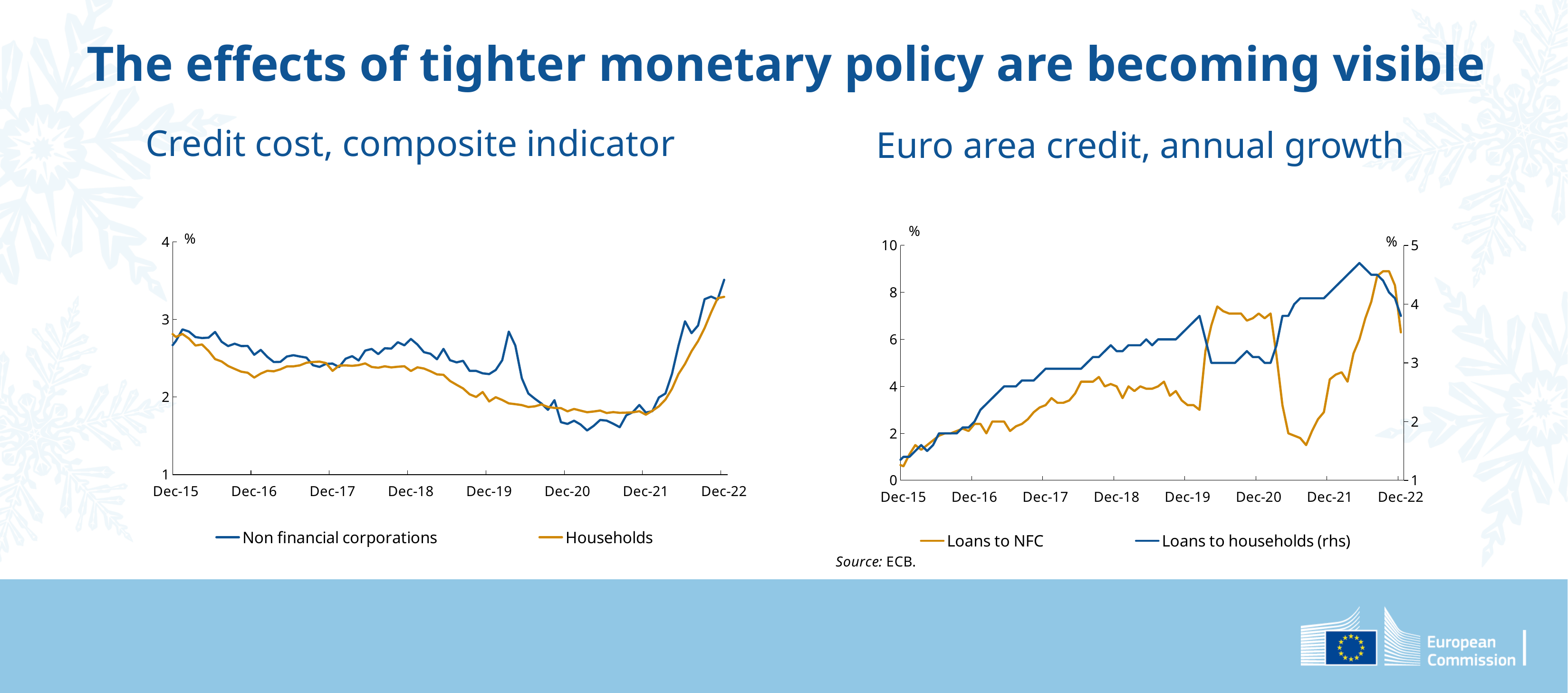
In the 'Euro area credit, annual growth' chart, is the value for Loans to NFC at Dec-15 greater or less than 2? less How many series does the legend of the 'Credit cost, composite indicator' chart list? 2 In the 'Euro area credit, annual growth' chart, is the value for Loans to NFC at Dec-22 greater or less than 4? greater In the 'Euro area credit, annual growth' chart, which series is plotted on the right-hand axis? Loans to households (rhs) In the 'Credit cost, composite indicator' chart, do the values for Non financial corporations rise or fall between Dec-21 and Dec-22? rise In the 'Credit cost, composite indicator' chart, is the value for Non financial corporations at Dec-20 greater or less than 2? less In the 'Credit cost, composite indicator' chart, which series is higher at Dec-19, Non financial corporations or Households? Non financial corporations What kind of chart is the 'Euro area credit, annual growth' chart? line chart What kind of chart is the 'Credit cost, composite indicator' chart? line chart In the 'Credit cost, composite indicator' chart, which series is shown in orange? Households